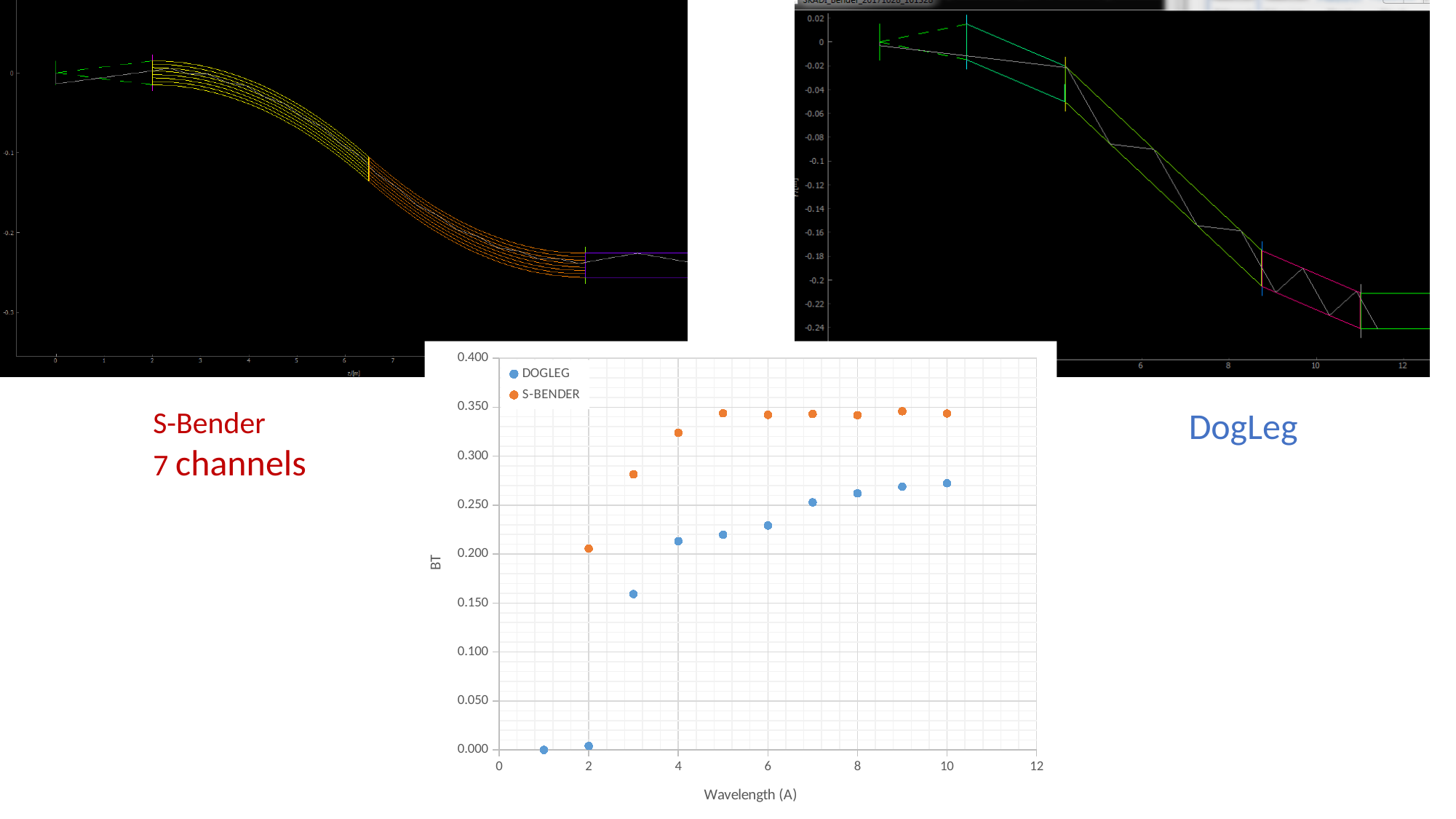
On the BT versus Wavelength chart, is the DOGLEG value at wavelength 10 greater or less than 0.250? greater On the BT versus Wavelength chart, which colour marks the S-BENDER series? orange On the BT versus Wavelength chart, is the DOGLEG value at wavelength 3 greater or less than 0.200? less On the BT versus Wavelength chart, which series has the higher BT at wavelength 6, DOGLEG or S-BENDER? S-BENDER On the BT versus Wavelength chart, what are the two series named in the legend? DOGLEG and S-BENDER On the BT versus Wavelength chart, what kind of chart is it? scatter chart On the BT versus Wavelength chart, how many DOGLEG points are plotted? 10 On the BT versus Wavelength chart, how many series does the legend list? 2 On the BT versus Wavelength chart, is the S-BENDER value at wavelength 2 greater or less than 0.250? less On the BT versus Wavelength chart, does the DOGLEG series rise or fall as wavelength increases from 1 to 10? rise